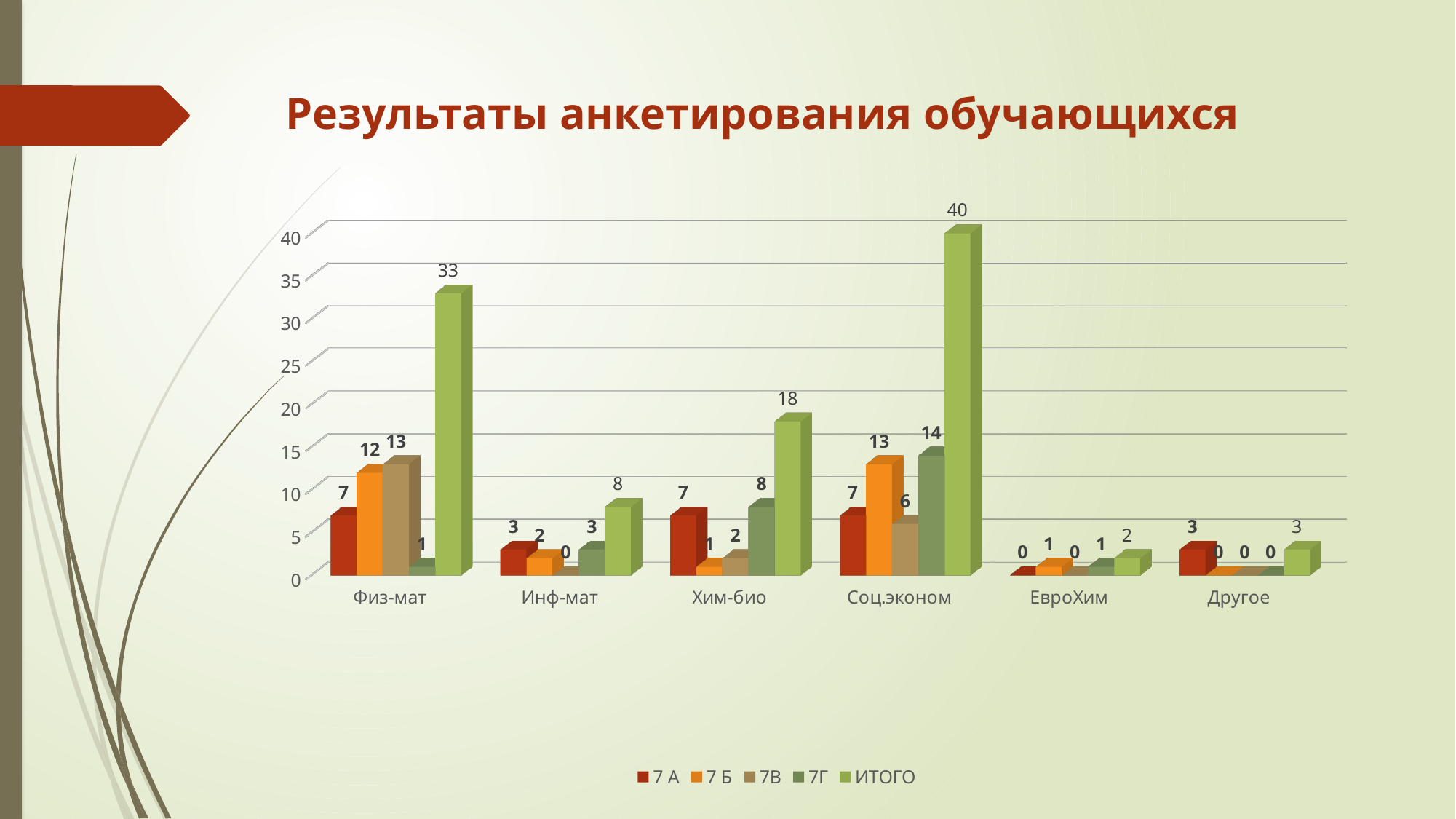
What is the value for 7Г in the Хим-био category? 8 What is the ИТОГО value for Соц.эконом? 40 What is the title of the slide? Результаты анкетирования обучающихся What is the value for 7 Б in the Физ-мат category? 12 What is the value for 7 А in the Другое category? 3 Which category has the highest ИТОГО value? Соц.эконом Which is larger: the 7 Б value for Соц.эконом or the 7 Б value for Физ-мат? Соц.эконом How many series does the legend list? 5 What is the difference between the ИТОГО values for Соц.эконом and Физ-мат? 7 How many categories are shown on the x axis? 6 What kind of chart is shown on the slide? Bar chart Which category has the lowest ИТОГО value? ЕвроХим